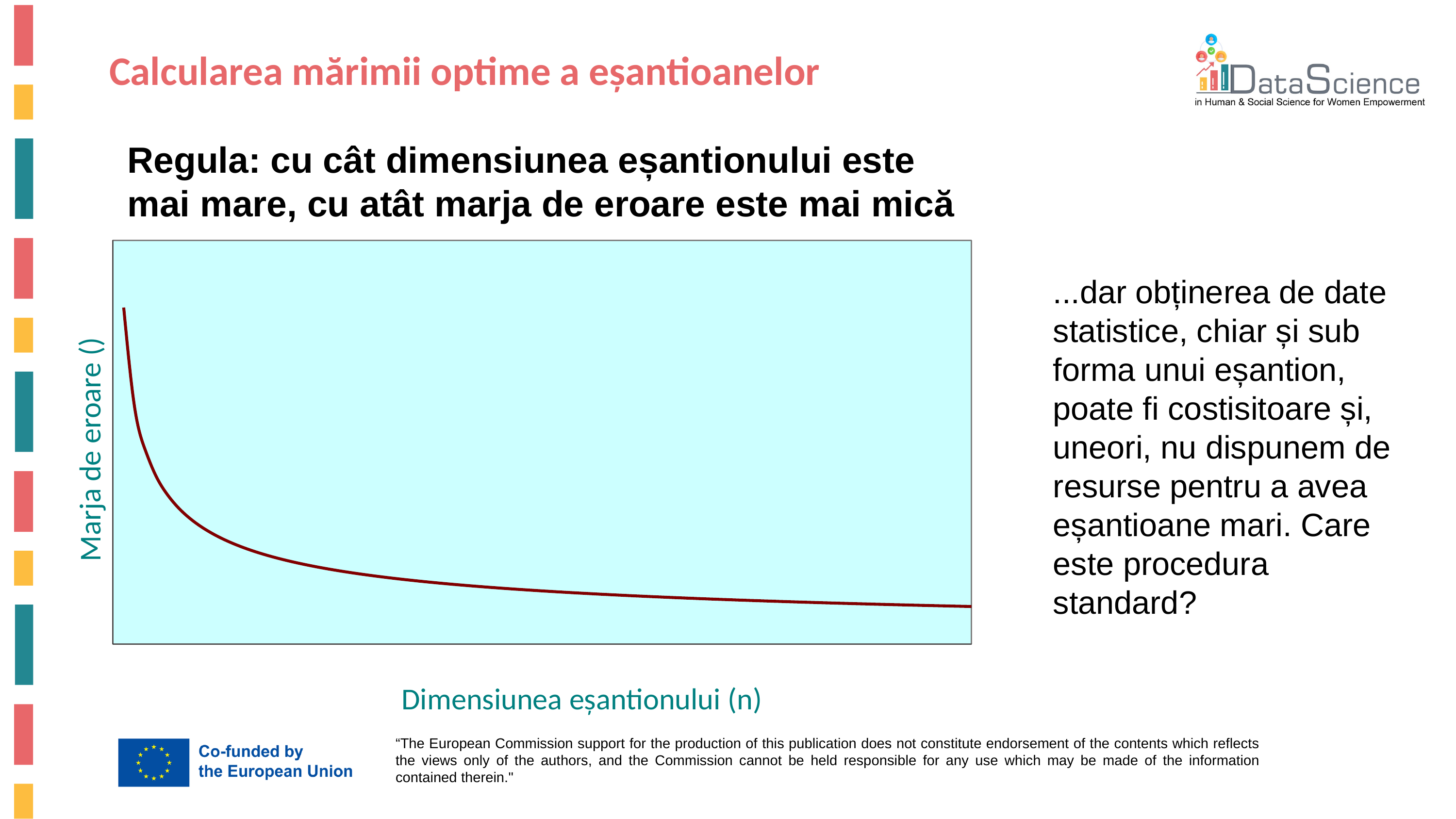
What is the label of the y axis of the chart? Marja de eroare () What kind of chart is shown on the slide? line chart Is the margin of error at the left end of the curve higher or lower than at the right end? higher How many lines are plotted on the chart? 1 Does the plotted line rise or fall as the sample size (n) increases along the x axis? fall What is the label of the x axis of the chart? Dimensiunea eșantionului (n)